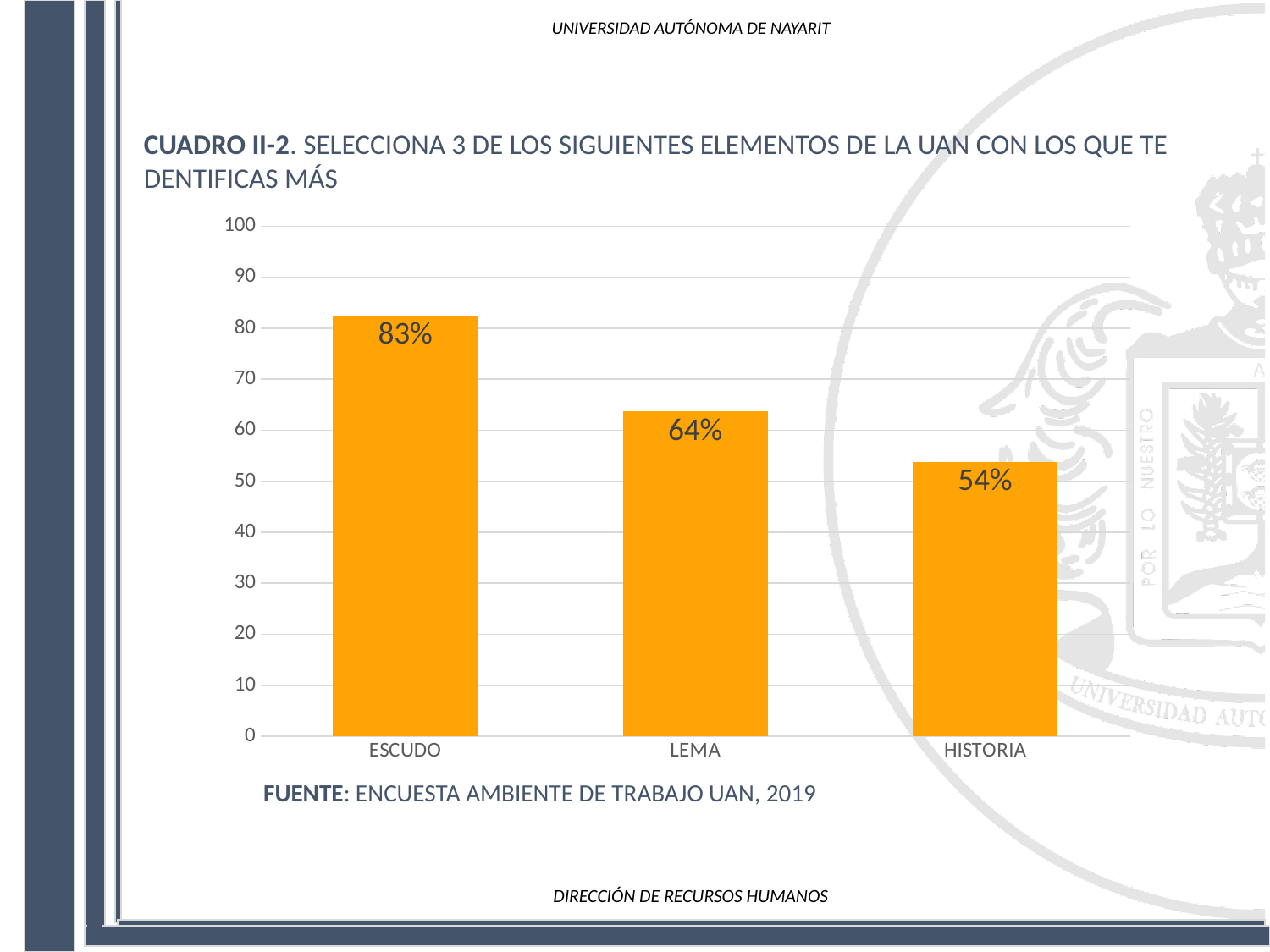
What is the value for HISTORIA? 54% Which category has the highest value? ESCUDO Do the values rise or fall from ESCUDO to HISTORIA along the x axis? fall What is the difference between the values for LEMA and HISTORIA? 10% What is the value for LEMA? 64% Is the value for HISTORIA greater or less than 60? less How many categories are shown on the x axis? 3 Which category has the lowest value? HISTORIA Which is larger, the value for LEMA or the value for HISTORIA? LEMA What kind of chart is shown on the slide? bar chart What is the value for ESCUDO? 83% What is the difference between the values for ESCUDO and LEMA? 19%